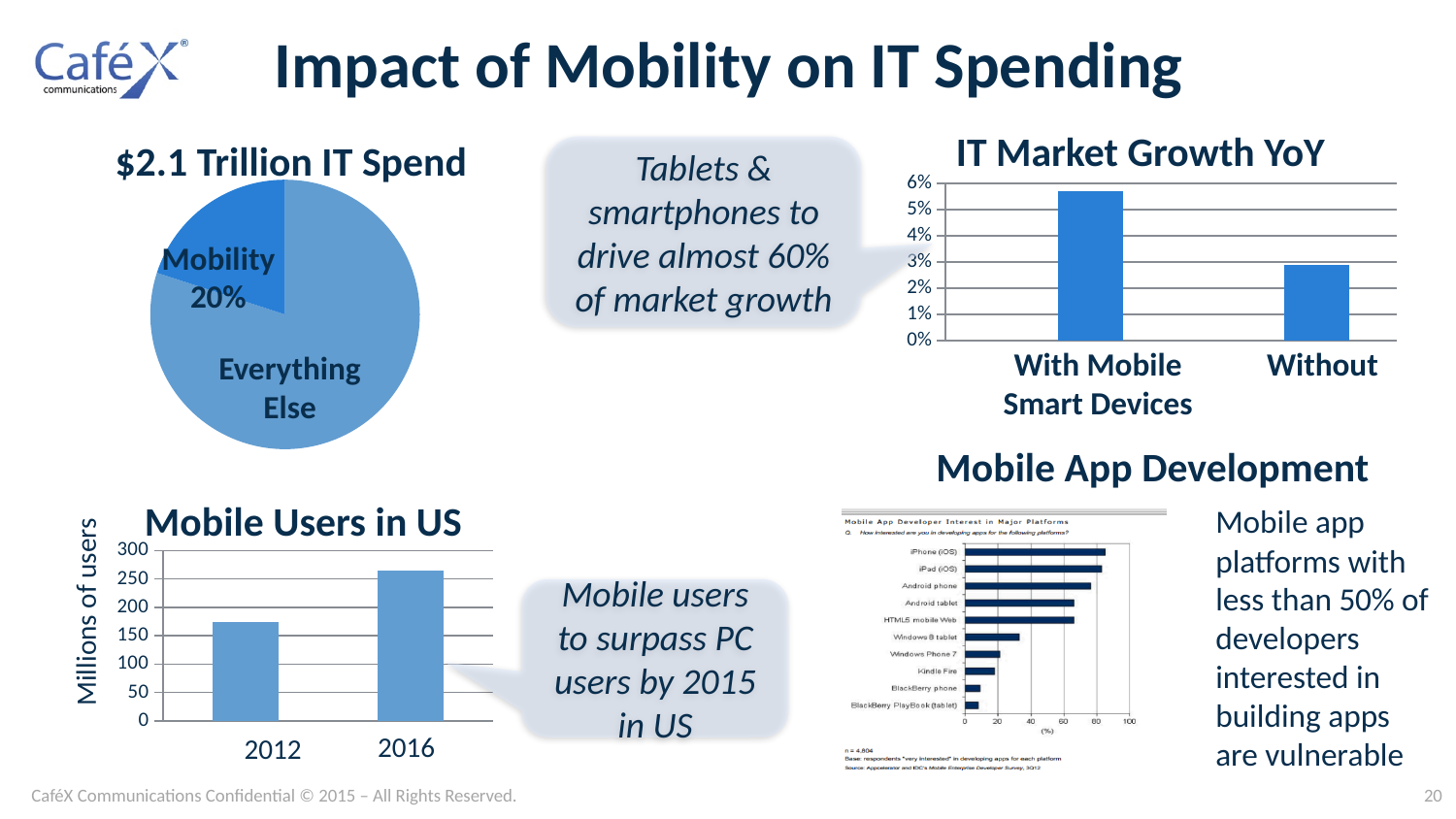
What is the y-axis label of the "Mobile Users in US" chart? Millions of users In the "IT Market Growth YoY" chart, is the value for Without greater or less than 2%? greater In the "Mobile Users in US" chart, is the value for 2012 greater or less than 150? greater What kind of chart is the "$2.1 Trillion IT Spend" chart? pie chart In the "IT Market Growth YoY" chart, is the value for With Mobile Smart Devices greater or less than 5%? greater In the "$2.1 Trillion IT Spend" pie chart, which slice is larger, Mobility or Everything Else? Everything Else In the "Mobile Users in US" chart, do the values rise or fall from 2012 to 2016? rise In the "$2.1 Trillion IT Spend" pie chart, what share is labelled for Mobility? 20% In the "IT Market Growth YoY" chart, which category has the higher growth? With Mobile Smart Devices In the "Mobile App Development" chart, which platform has the highest developer interest? iPhone (iOS) How many categories are shown in the "IT Market Growth YoY" chart? 2